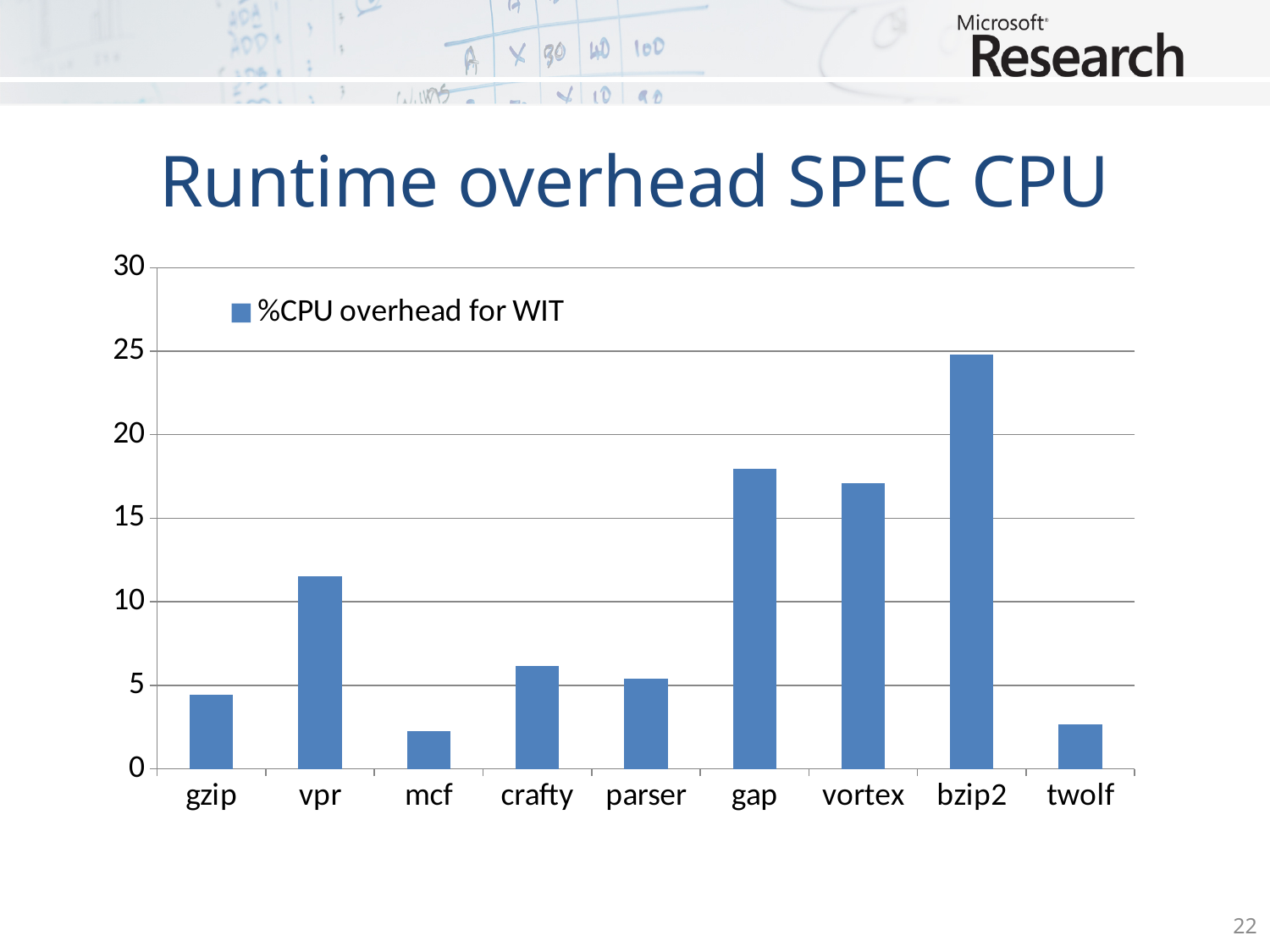
Which benchmark has the highest %CPU overhead for WIT? bzip2 What kind of chart is shown on the slide? bar chart Which has a larger %CPU overhead for WIT, vpr or crafty? vpr How many series does the legend list? 1 Is the value for mcf greater or less than 5? less Is the value for bzip2 greater or less than 20? greater How many benchmarks (categories) are shown on the x axis? 9 Is the value for vpr greater or less than 10? greater What is the legend entry for the series plotted? %CPU overhead for WIT What is the title of the slide containing the chart? Runtime overhead SPEC CPU